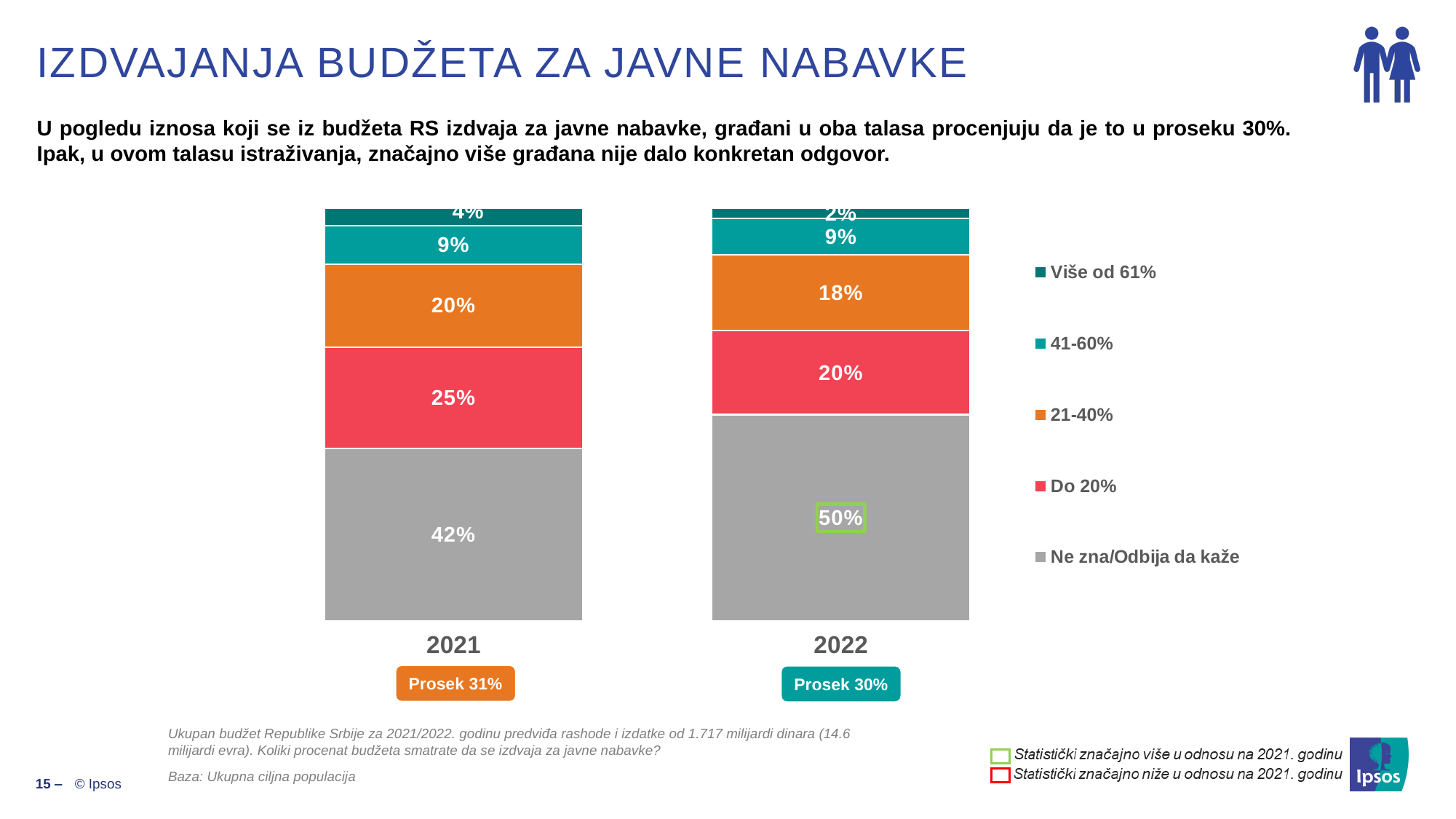
What is the value of the "21-40%" segment for 2022? 18% How many years (bars) are shown in the chart? 2 What type of chart is shown on the slide? Stacked bar chart What percentage of respondents answered "Ne zna/Odbija da kaže" in 2022? 50% Is the "Do 20%" share larger in 2021 or in 2022? 2021 Which segment is the smallest in the 2022 bar? Više od 61% What is the average (Prosek) shown below the 2022 bar? Prosek 30% What is the value of the "Više od 61%" segment for 2021? 4% What is the value of the "Do 20%" segment for 2021? 25% By how many percentage points did the "Ne zna/Odbija da kaže" share change from 2021 to 2022? 8 percentage points Which segment is the largest in the 2021 bar? Ne zna/Odbija da kaže How many categories does the legend list? 5